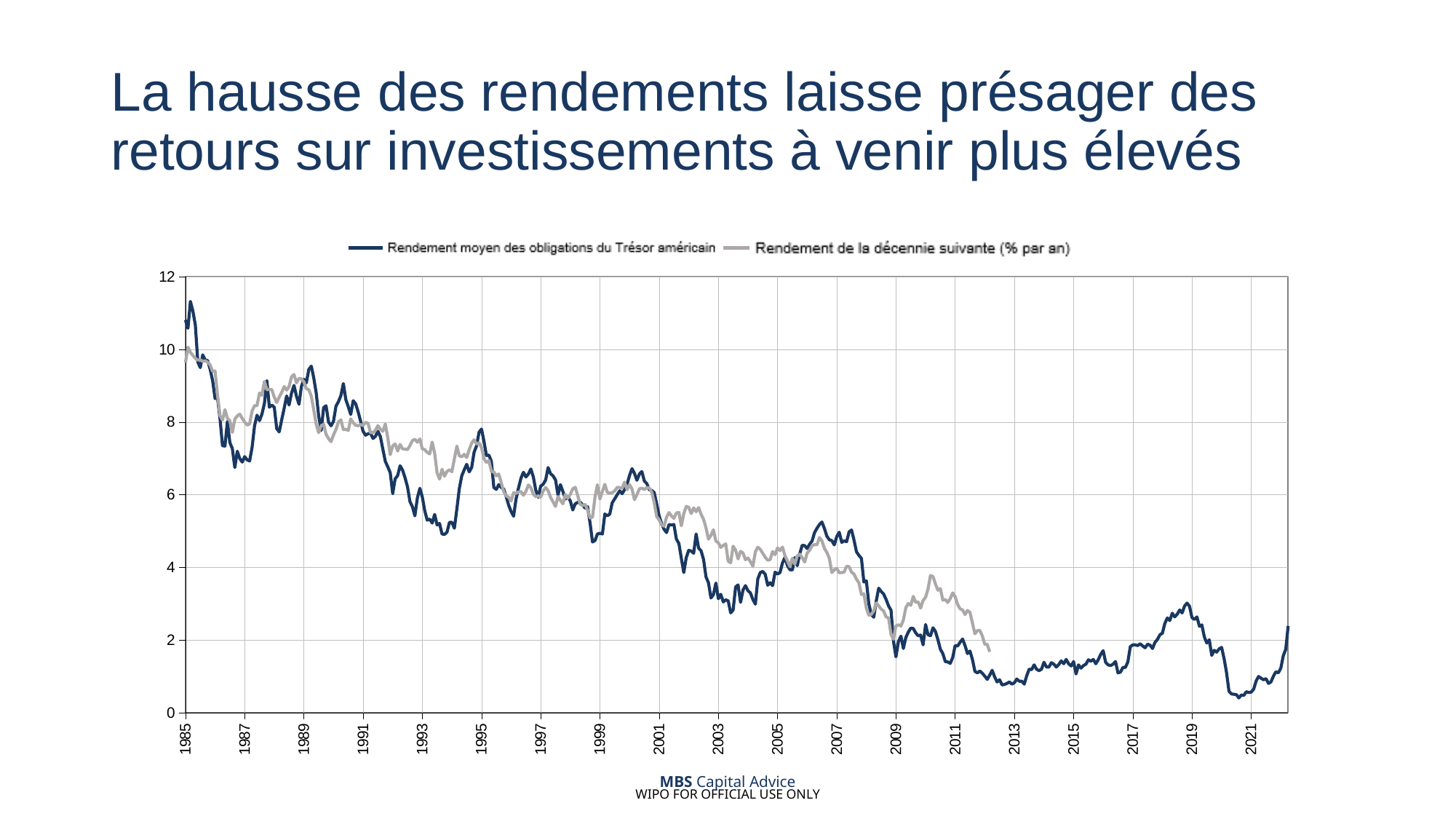
What kind of chart is shown on the slide? line chart How many series does the legend list? 2 What are the two series named in the legend? Rendement moyen des obligations du Trésor américain; Rendement de la décennie suivante (% par an) Is the value of 'Rendement moyen des obligations du Trésor américain' around 2013 greater or less than 2? less Is the value of 'Rendement de la décennie suivante (% par an)' around 1993 greater or less than 6? greater Overall, does the 'Rendement de la décennie suivante (% par an)' series rise or fall from 1985 to 2011? fall How many year labels are shown on the x axis? 19 Is the value of 'Rendement moyen des obligations du Trésor américain' around 2019 greater or less than 4? less Which series extends further to the right along the x axis? Rendement moyen des obligations du Trésor américain Overall, does the 'Rendement moyen des obligations du Trésor américain' series rise or fall from 1985 to 2021? fall